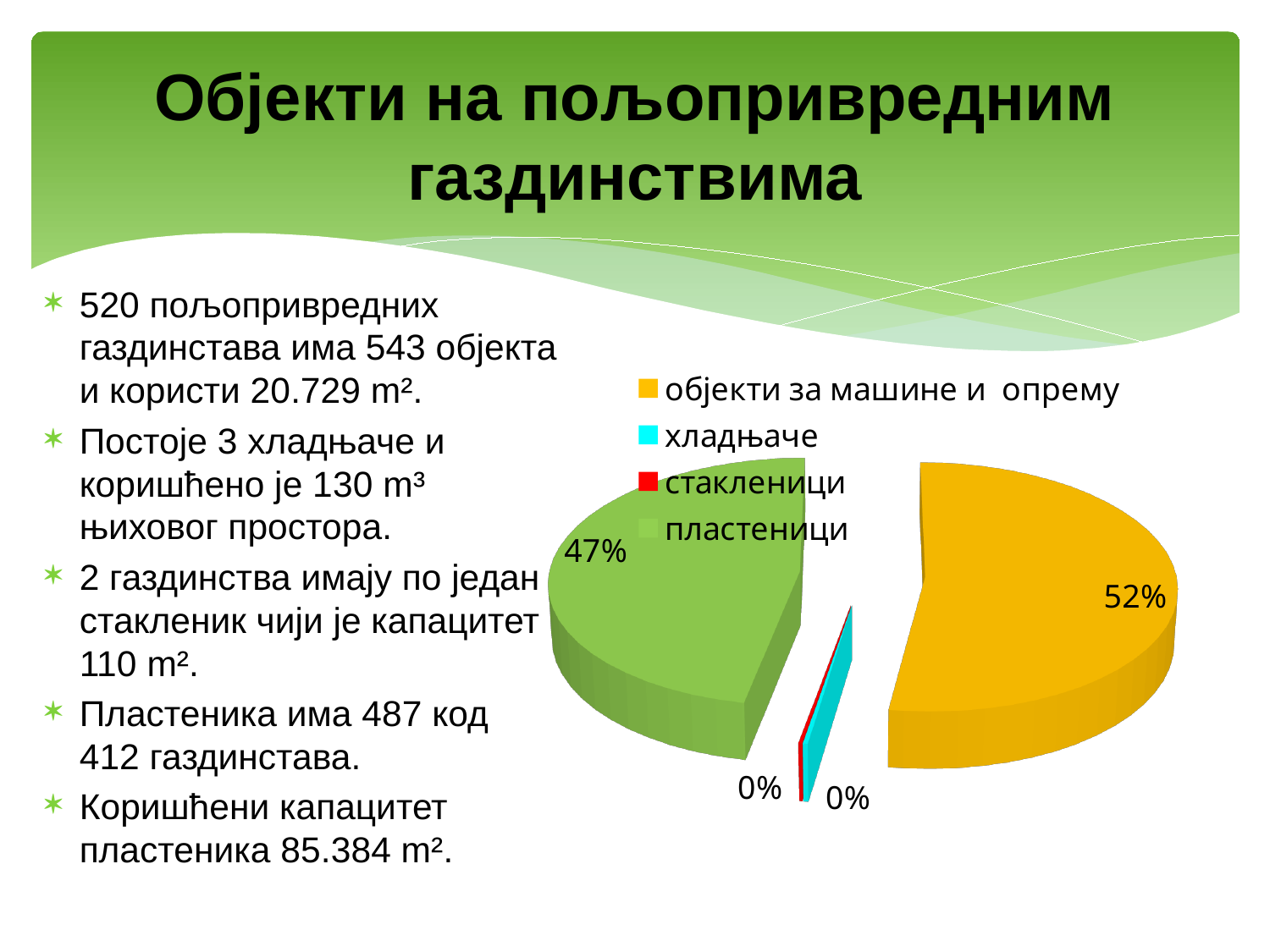
What percentage is shown for "хладњаче"? 0% Which category has the largest slice of the pie? објекти за машине и опрему How many categories does the pie chart show? 4 Which is larger, the slice for "објекти за машине и опрему" or the slice for "пластеници"? објекти за машине и опрему What share of the pie does "објекти за машине и опрему" have? 52% What colour is the slice for "пластеници"? green How many entries does the chart legend list? 4 Is the share for "пластеници" greater or less than 50%? less What percentage is shown for "стакленици"? 0% What kind of chart is shown on the slide? pie chart By how many percentage points does "објекти за машине и опрему" exceed "пластеници"? 5 percentage points What share of the pie does "пластеници" have? 47%